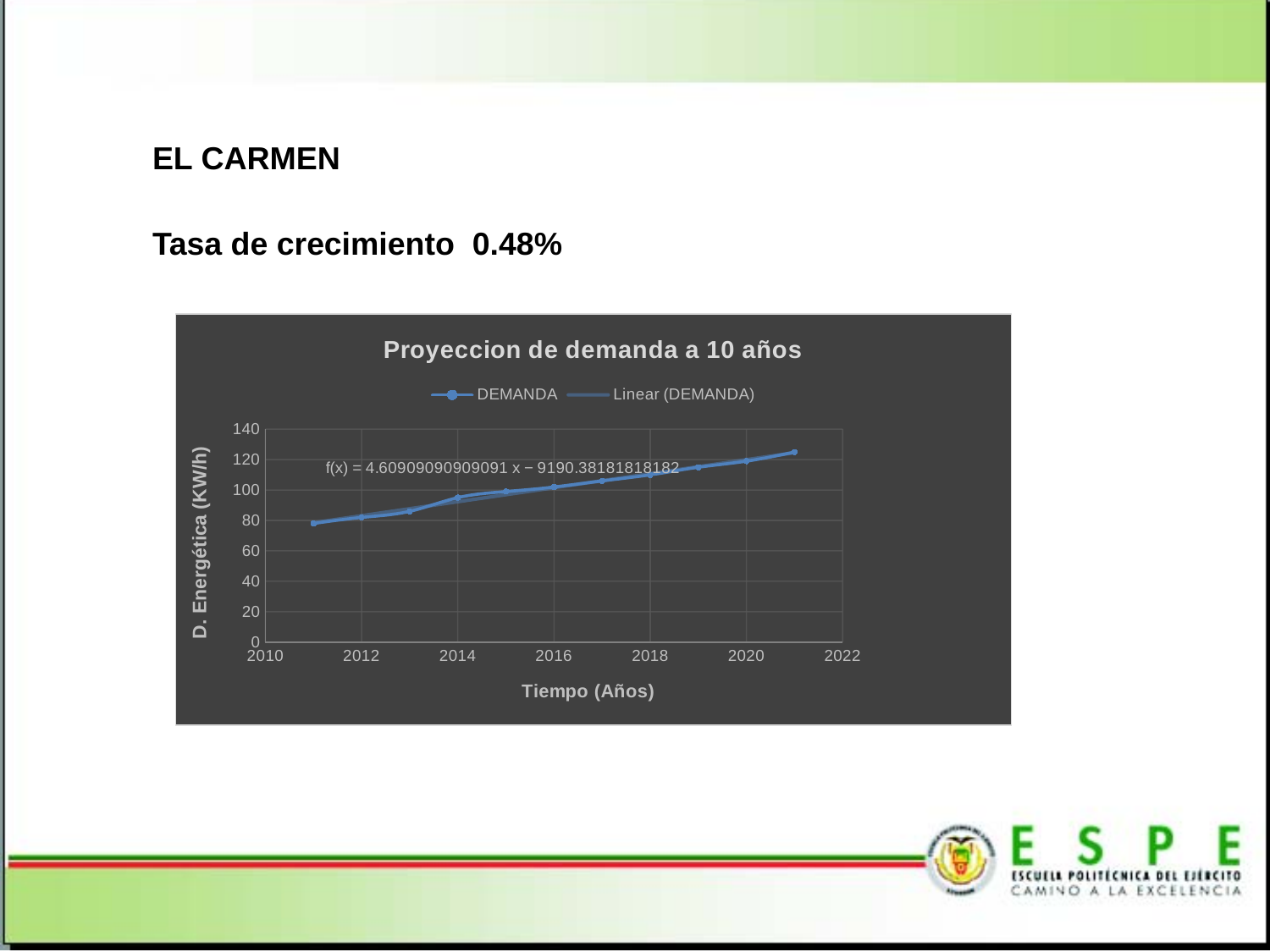
What kind of chart is shown on the slide? Line chart Do the DEMANDA values rise or fall from 2011 to 2021? Rise Which is larger, the DEMANDA value for 2021 or for 2011? 2021 What is the title of the chart? Proyeccion de demanda a 10 años What is the label of the x axis? Tiempo (Años) Is the DEMANDA value for 2013 greater or less than 100? less Which year has the highest DEMANDA value? 2021 Is the DEMANDA value for 2019 greater or less than 100? greater How many data points are plotted for the DEMANDA series? 11 Is the DEMANDA value for 2021 greater or less than 120? greater How many series does the chart legend list? 2 Which year has the lowest DEMANDA value? 2011